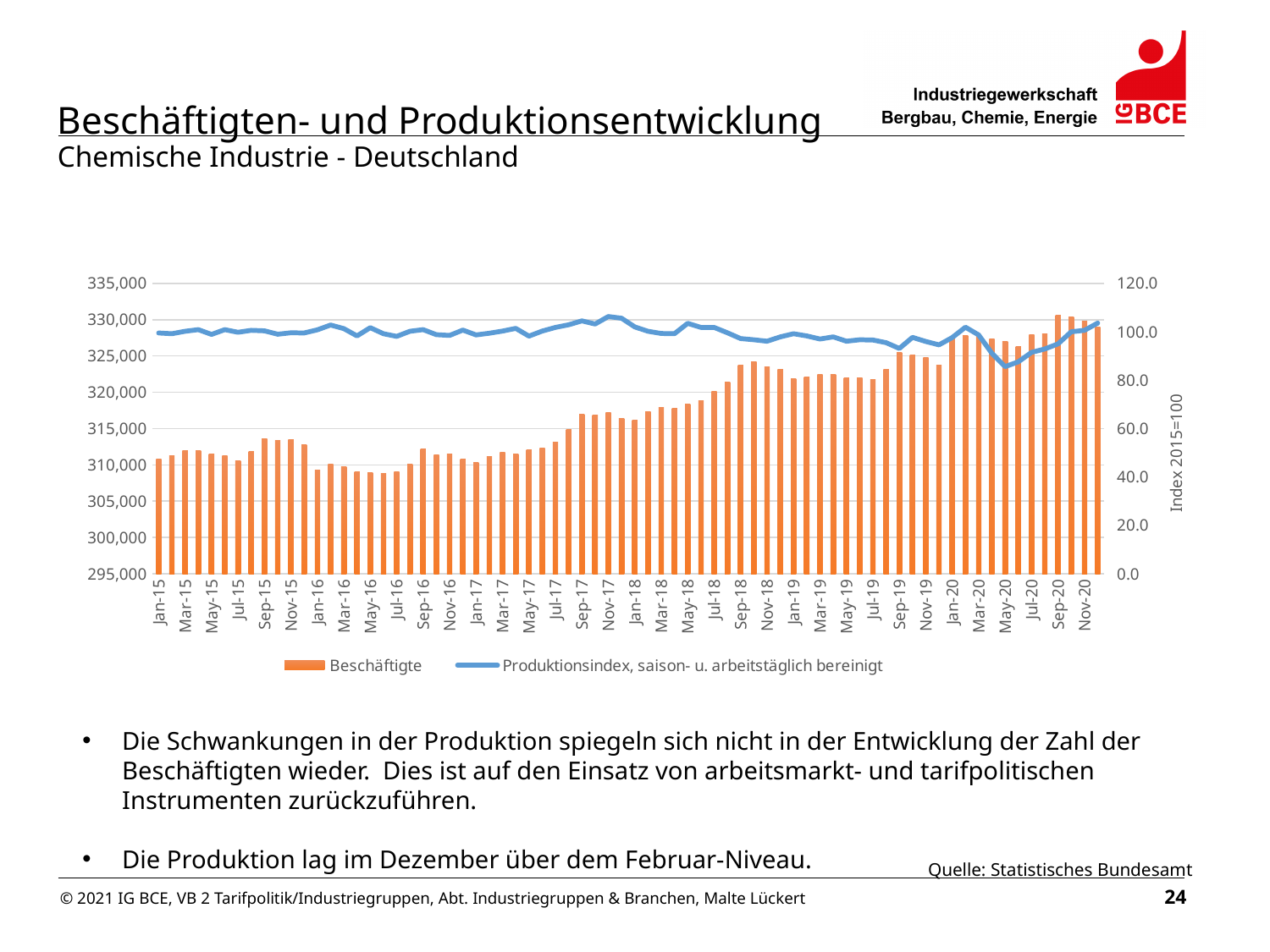
Is the Beschäftigte value for Sep-20 greater or less than 325,000? greater In which month does the Produktionsindex line reach its lowest point? May-20 Which is larger, the Beschäftigte value for Jan-16 or for Jan-19? Jan-19 Is the Produktionsindex value for May-20 greater or less than 100.0? less How many series does the legend list? 2 What kind of chart is shown on the slide? A combined bar and line chart Do the Beschäftigte bars generally rise or fall from Jan-17 to Sep-18? rise Is the Produktionsindex value for Nov-17 greater or less than 100.0? greater Which series is drawn as bars in the chart? Beschäftigte What is the title of the right-hand vertical axis? Index 2015=100